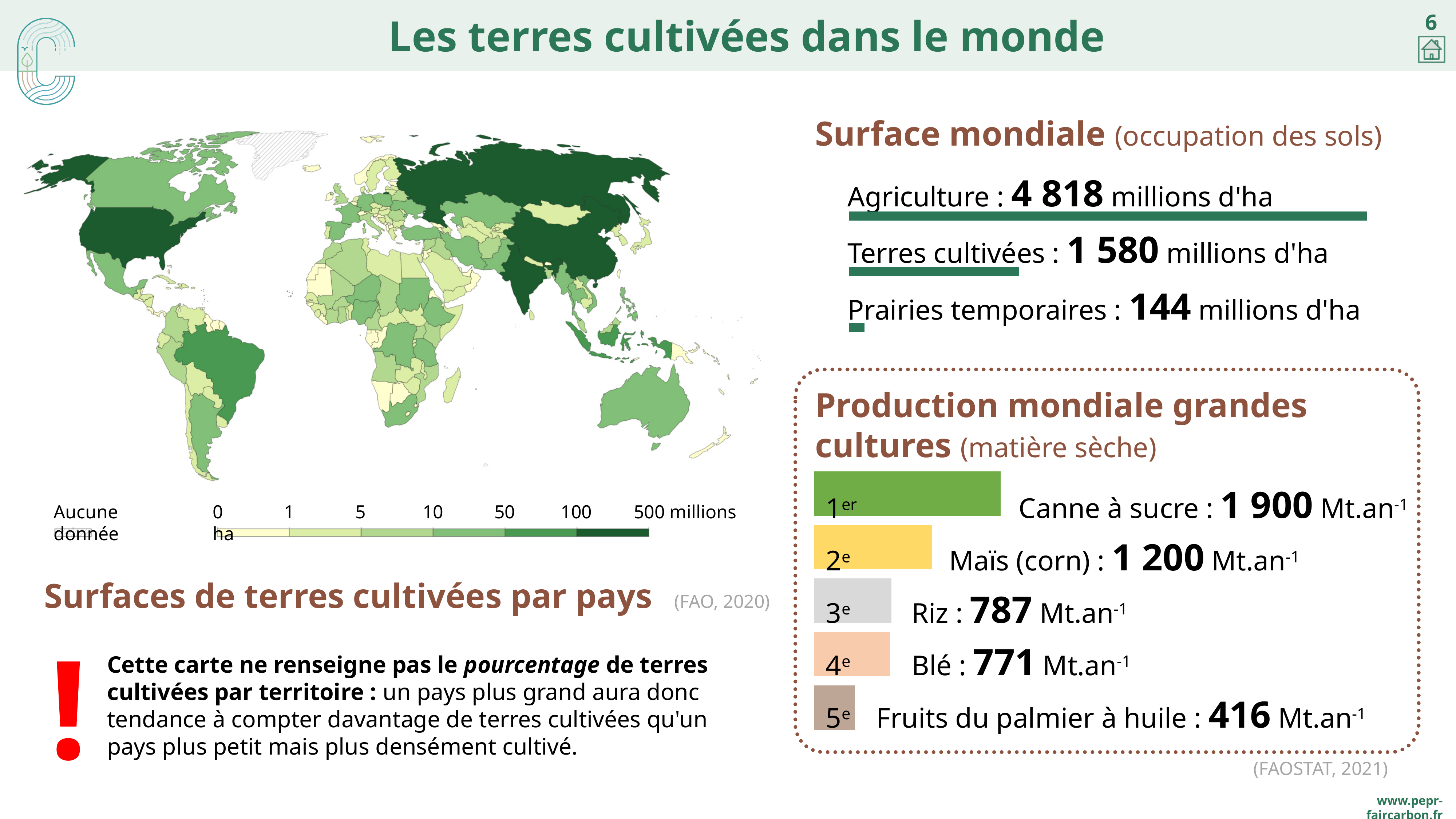
How many crops are shown in the 'Production mondiale grandes cultures' chart? 5 In the 'Production mondiale grandes cultures' chart, which crop has the lowest production? Fruits du palmier à huile In the 'Surface mondiale' chart, what is the value for Terres cultivées? 1 580 millions d'ha In the 'Surface mondiale' chart, which category has the smallest value? Prairies temporaires In the 'Production mondiale grandes cultures' chart, what is the difference between the production of Maïs (corn) and Riz? 413 Mt.an-1 In the 'Production mondiale grandes cultures' chart, what is the production value for Riz? 787 Mt.an-1 In the 'Production mondiale grandes cultures' chart, what is the production value for Canne à sucre? 1 900 Mt.an-1 In the 'Production mondiale grandes cultures' chart, which has the larger production, Riz or Blé? Riz In the 'Surface mondiale' chart, what is the difference between Agriculture and Terres cultivées? 3 238 millions d'ha In the 'Production mondiale grandes cultures' chart, which crop has the highest production? Canne à sucre In the 'Production mondiale grandes cultures' chart, what colour is the bar for Maïs (corn)? yellow What kind of chart is the 'Production mondiale grandes cultures' chart? bar chart